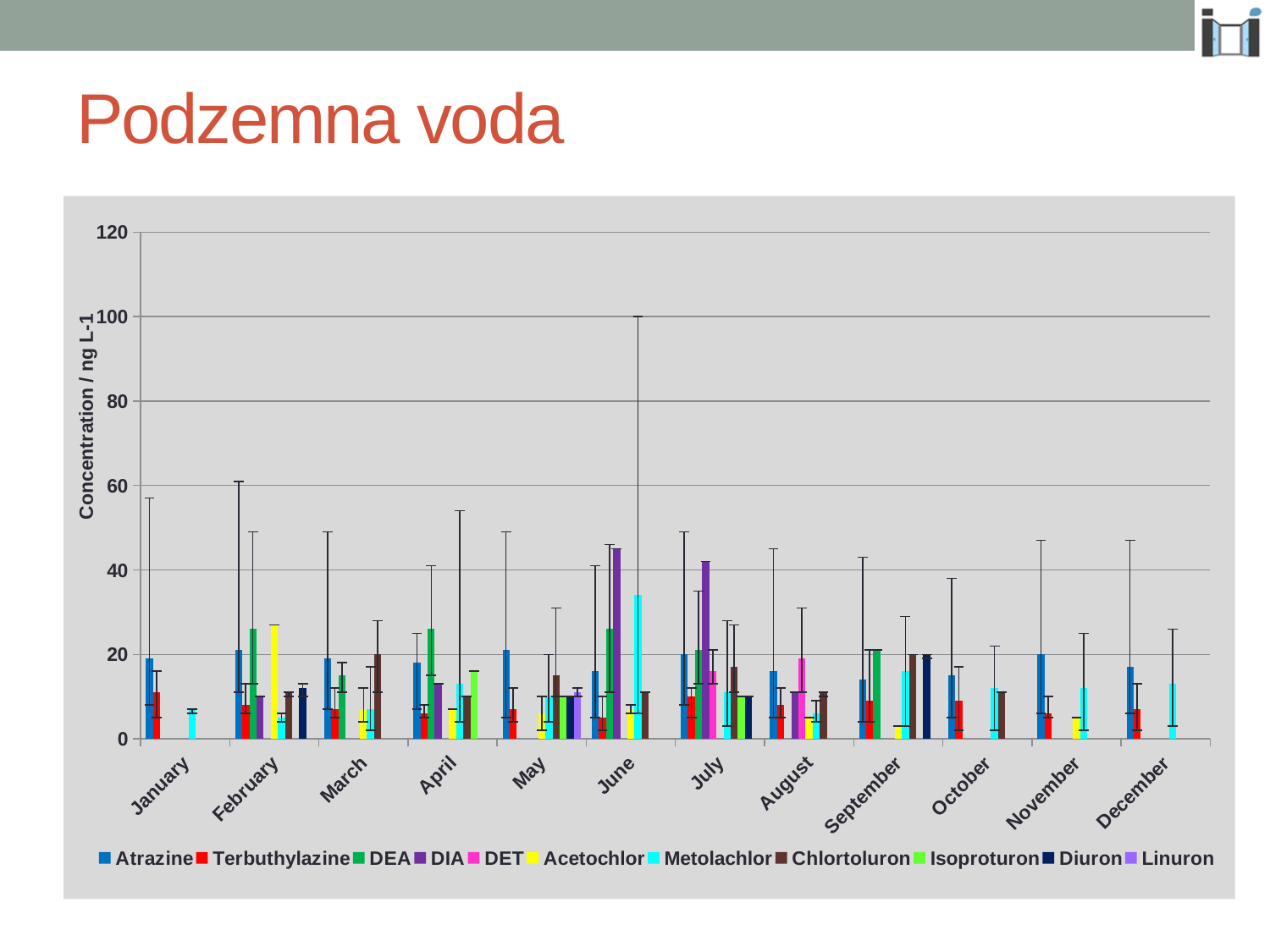
How many months are shown along the x axis of the chart? 12 Is the value for DEA in April greater or less than 20? greater In June, which is larger: the DIA bar or the Metolachlor bar? DIA How many series does the chart legend list? 11 Which series is listed first in the legend? Atrazine Is the value for Acetochlor in February greater or less than 20? greater Is the value for DIA in June greater or less than 40? greater In February, which is larger: the Acetochlor bar or the Metolachlor bar? Acetochlor What kind of chart is shown on the slide? bar chart What is the label of the y axis? Concentration / ng L-1